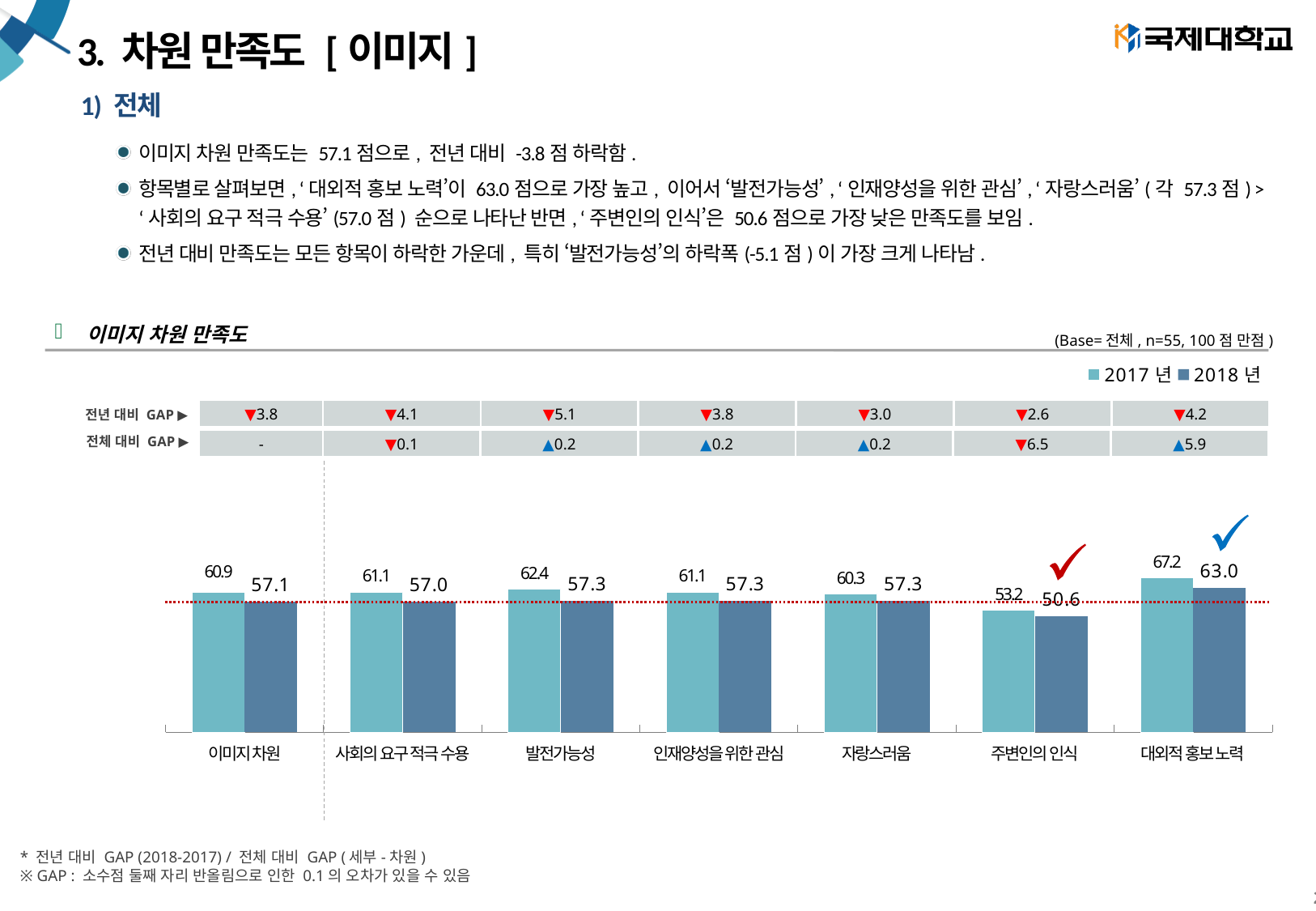
What is the difference between the 2017년 and 2018년 values for 대외적 홍보 노력? 4.2 What is the 2017년 value for 발전가능성? 62.4 How many categories are shown on the x axis of the chart? 7 What is the difference between the 2017년 and 2018년 values for 발전가능성? 5.1 Which category has the highest 2018년 value? 대외적 홍보 노력 What is the 2018년 value for 주변인의 인식? 50.6 Which is larger, the 2018년 value for 사회의 요구 적극 수용 or the 2018년 value for 주변인의 인식? 사회의 요구 적극 수용 What is the 2017년 value for 이미지차원? 60.9 How many series does the legend list? 2 What kind of chart is shown on the slide? bar chart What is the 2018년 value for 대외적 홍보 노력? 63.0 Which category has the lowest 2017년 value? 주변인의 인식